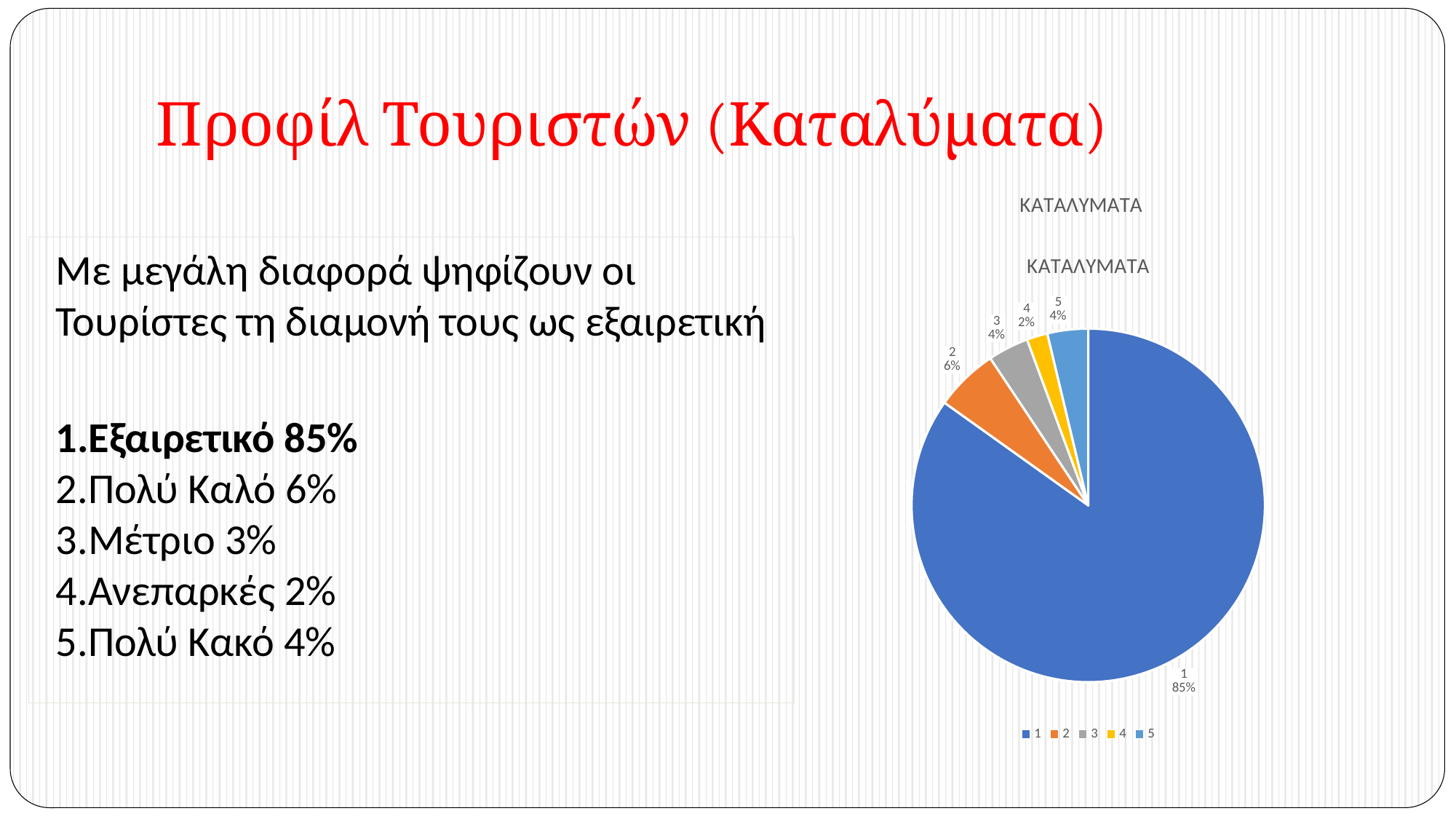
What percentage is shown for slice 5 in the pie chart? 4% What percentage is shown for slice 2 in the pie chart? 6% What is the title of the chart? ΚΑΤΑΛΥΜΑΤΑ What percentage is shown for slice 4 in the pie chart? 2% What is the difference in percentage points between slice 1 and slice 2? 79 What type of chart is shown on the slide? pie chart Which is larger, slice 2 or slice 4? 2 Which slice has the smallest share of the pie? 4 Which slice has the largest share of the pie? 1 What percentage is shown for slice 1 in the pie chart? 85% How many slices does the pie chart have? 5 How many entries does the legend list? 5